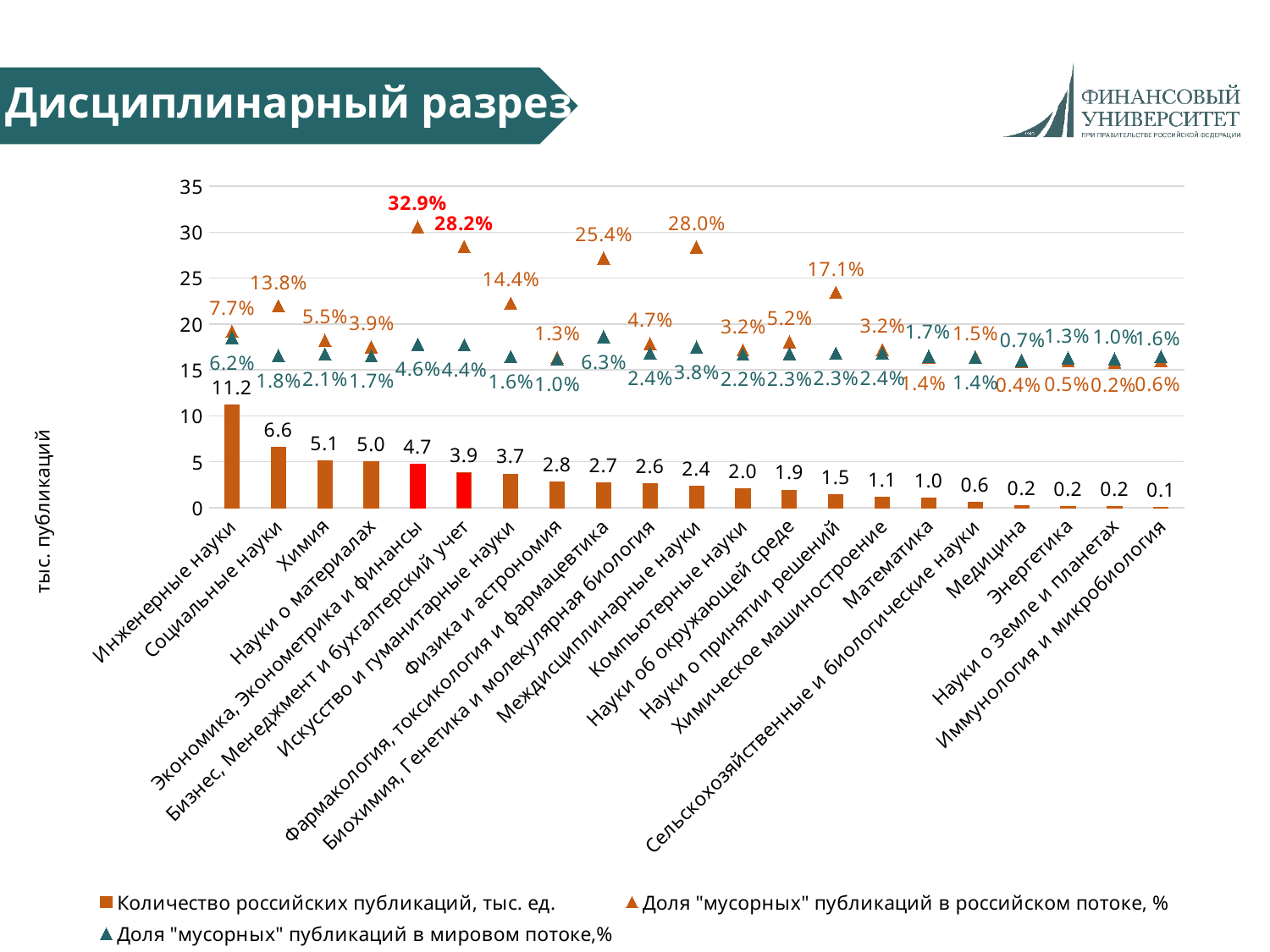
What kind of chart is this? Bar chart with triangle marker series What is the share of "junk" publications in the world flow for Фармакология, токсикология и фармацевтика? 6.3% Which two disciplines have their bars highlighted in red? Экономика, Эконометрика и финансы and Бизнес, Менеджмент и бухгалтерский учет What is the share of "junk" publications in the Russian flow for Экономика, Эконометрика и финансы? 32.9% Do the bar values rise or fall from left to right along the x axis? Fall How many thousand Russian publications are shown for Инженерные науки? 11.2 How many disciplines are shown on the x axis? 21 What is the difference in thousand publications between Социальные науки and Химия? 1.5 Which discipline has the highest share of "junk" publications in the Russian flow? Экономика, Эконометрика и финансы Which discipline has the highest number of Russian publications? Инженерные науки Which has more Russian publications: Физика и астрономия or Фармакология, токсикология и фармацевтика? Физика и астрономия How many series does the legend list? 3